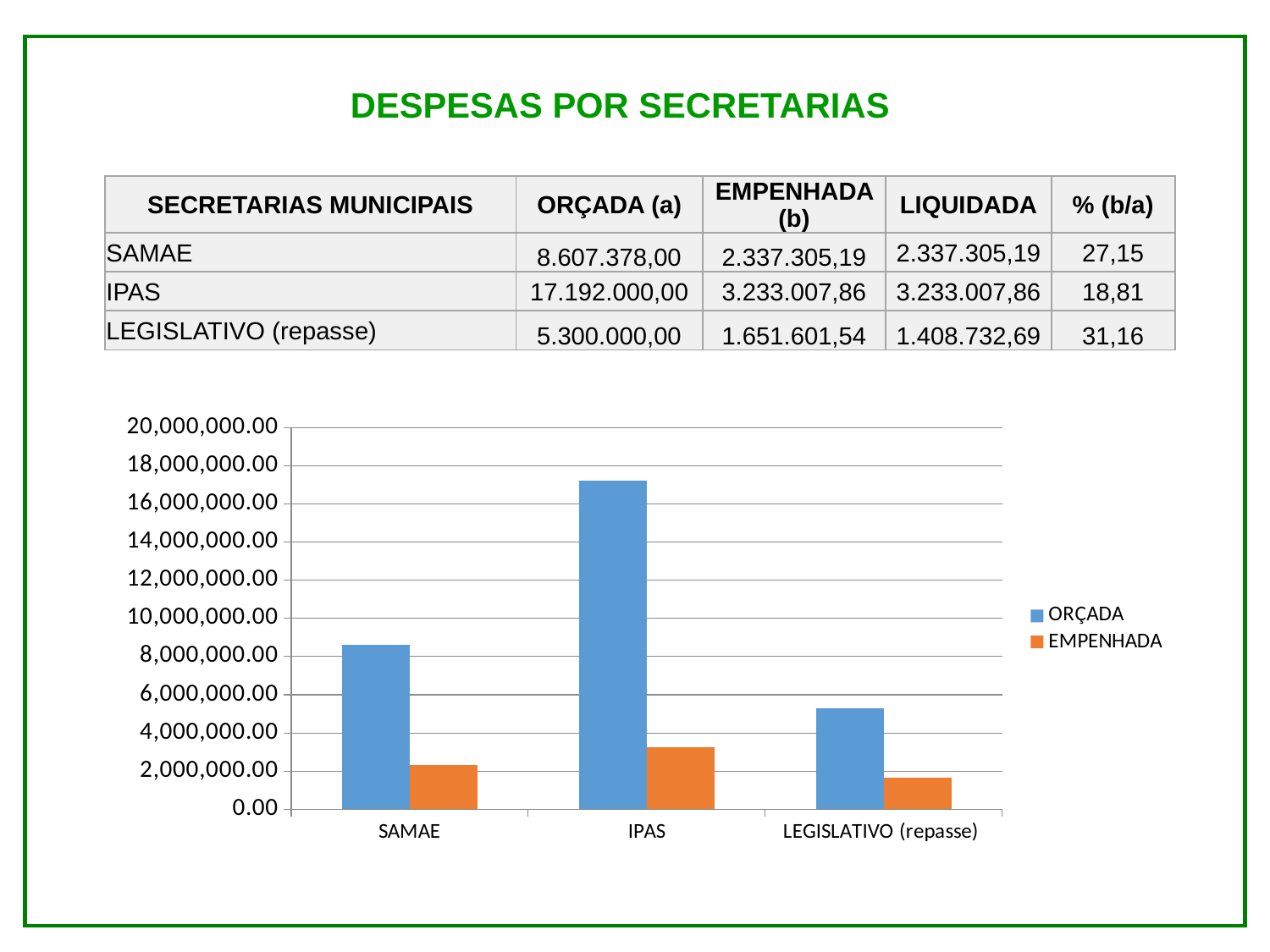
According to the table on the slide, what is the ORÇADA (a) value for IPAS? 17.192.000,00 Which category has the highest EMPENHADA bar? IPAS Is the ORÇADA value for SAMAE greater or less than 10,000,000.00? less How many series does the chart's legend list? 2 How many categories are shown on the x axis of the chart? 3 Which category has the highest ORÇADA bar? IPAS Which colour represents the EMPENHADA series in the chart? orange Which category has the lowest ORÇADA bar? LEGISLATIVO (repasse) Which is larger, the ORÇADA bar for SAMAE or the ORÇADA bar for LEGISLATIVO (repasse)? SAMAE Which category has the lowest EMPENHADA bar? LEGISLATIVO (repasse) Is the ORÇADA value for IPAS greater or less than 16,000,000.00? greater What kind of chart is shown on the slide? bar chart